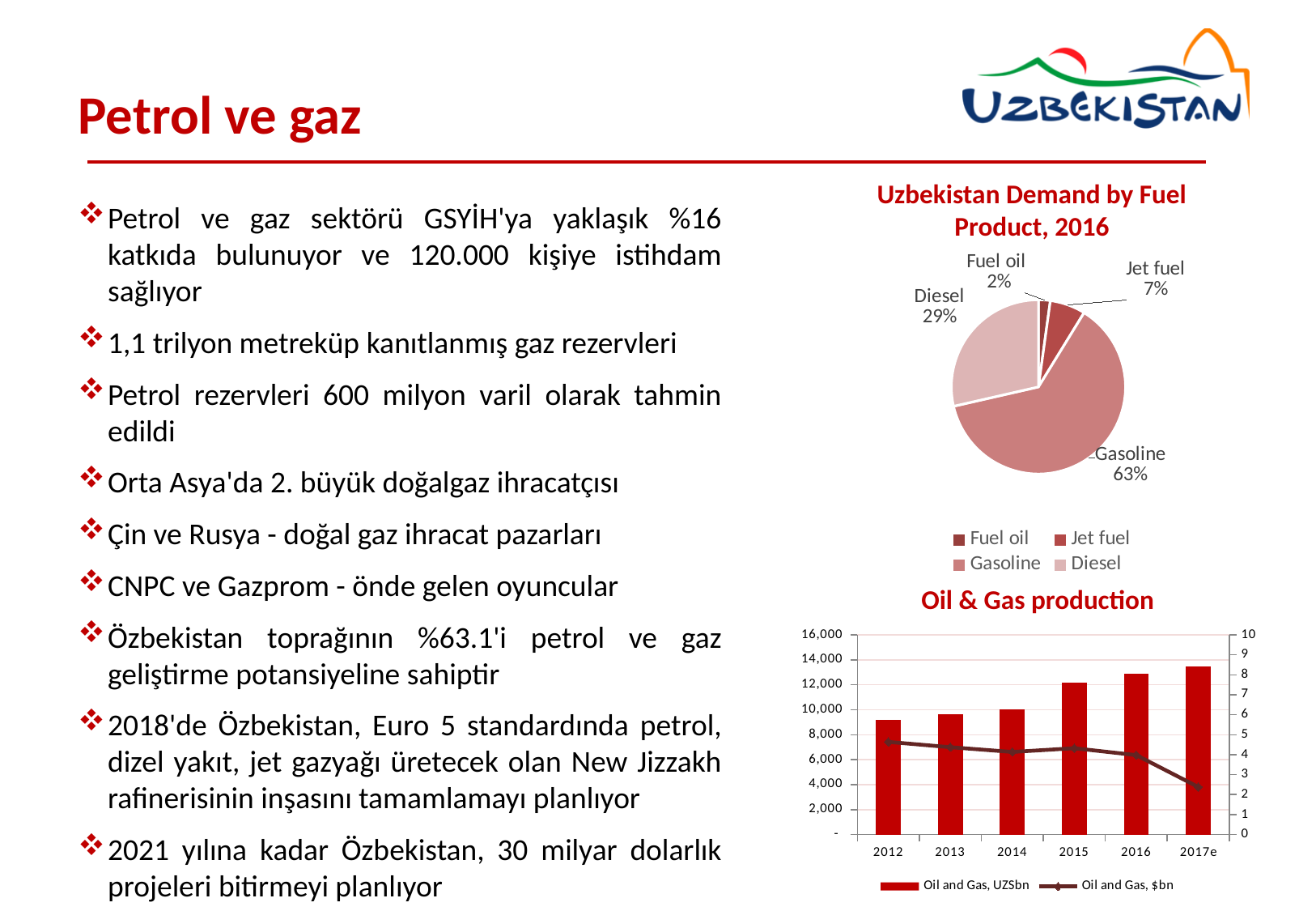
How many series does the legend of the 'Oil & Gas production' chart list? 2 In the 'Oil & Gas production' chart, is the 'Oil and Gas, UZSbn' value for 2012 greater or less than 10,000? less In the 'Uzbekistan Demand by Fuel Product, 2016' pie chart, what share does Gasoline have? 63% In the 'Uzbekistan Demand by Fuel Product, 2016' pie chart, what is the difference in percentage points between the Gasoline and Diesel shares? 34 In the 'Uzbekistan Demand by Fuel Product, 2016' pie chart, what share does Diesel have? 29% In the 'Uzbekistan Demand by Fuel Product, 2016' pie chart, which fuel product has the largest share? Gasoline In the 'Uzbekistan Demand by Fuel Product, 2016' pie chart, which fuel product has the smallest share? Fuel oil In the 'Uzbekistan Demand by Fuel Product, 2016' pie chart, how many fuel products are shown? 4 In the 'Oil & Gas production' chart, is the 'Oil and Gas, UZSbn' value for 2017e greater or less than 12,000? greater In the 'Oil & Gas production' chart, do the 'Oil and Gas, UZSbn' bars rise or fall from 2012 to 2017e? rise What type of chart is the 'Oil & Gas production' chart? Combined bar and line chart In the 'Uzbekistan Demand by Fuel Product, 2016' pie chart, which is larger, the Jet fuel share or the Fuel oil share? Jet fuel